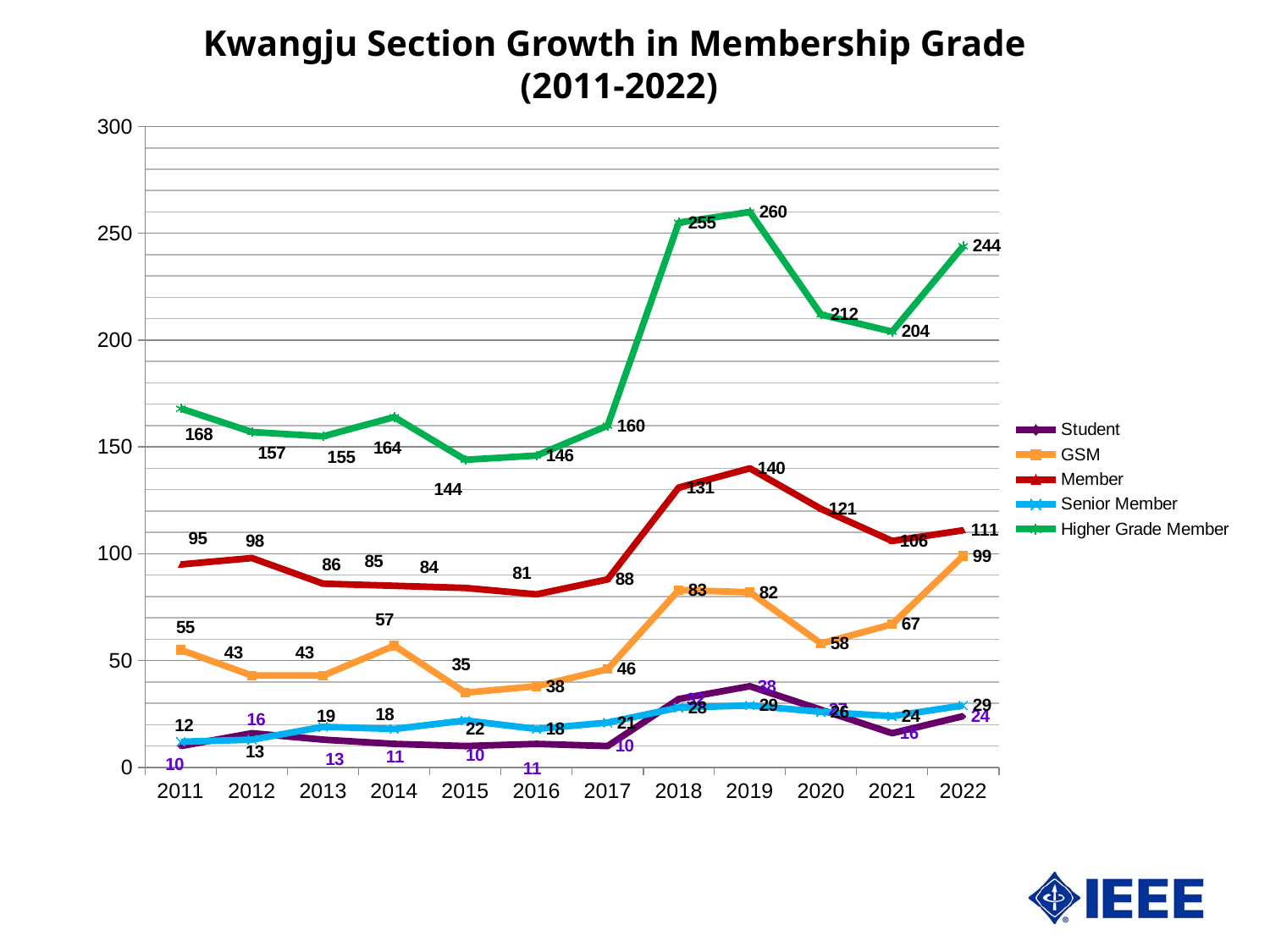
What is the value for Member in 2018? 131 In which year is the Higher Grade Member value highest? 2019 What type of chart is shown on the slide? line chart What is the value for Senior Member in 2015? 22 What is the difference between the Higher Grade Member values in 2018 and 2017? 95 Which is larger, the Member value in 2019 or the Member value in 2020? 2019 What is the value for GSM in 2022? 99 How many years are plotted along the x axis? 12 What is the value for Higher Grade Member in 2019? 260 How many series does the legend list? 5 In which year is the GSM value lowest? 2015 Is the Higher Grade Member value in 2020 greater or less than 200? greater